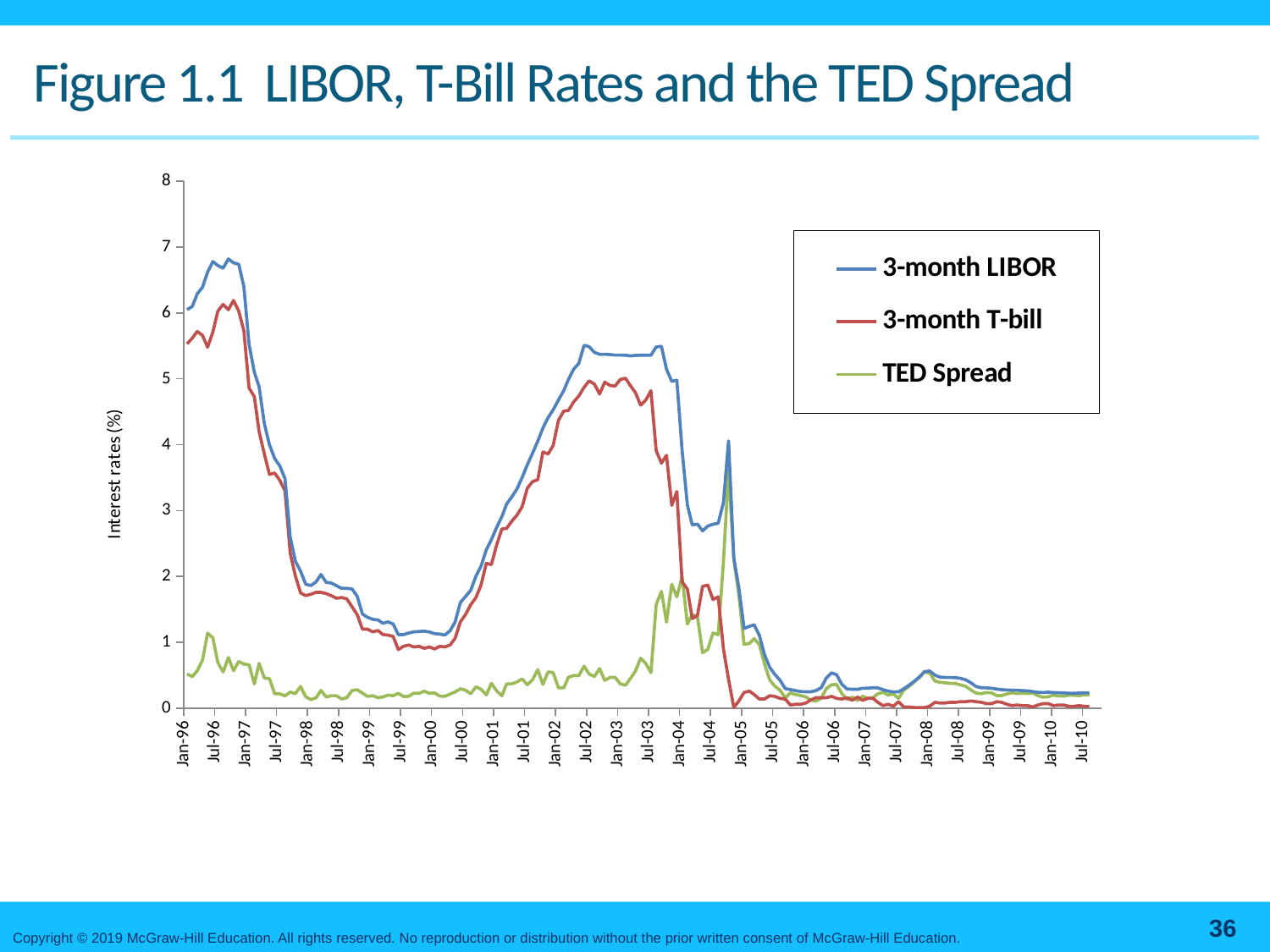
What is the label on the vertical axis? Interest rates (%) Does the 3-month LIBOR rise or fall between Jan-97 and Jan-99? fall Is the 3-month LIBOR value at Jul-02 greater or less than 5? greater Is the 3-month LIBOR value at Jan-98 greater or less than 3? less How many series does the legend list? 3 What is the title of the chart? Figure 1.1 LIBOR, T-Bill Rates and the TED Spread Is the peak value of the TED Spread greater or less than 3? greater What kind of chart is shown on the slide? line chart At Jan-97, which is higher, the 3-month LIBOR or the 3-month T-bill? 3-month LIBOR Which series has the lowest value at Jan-96? TED Spread